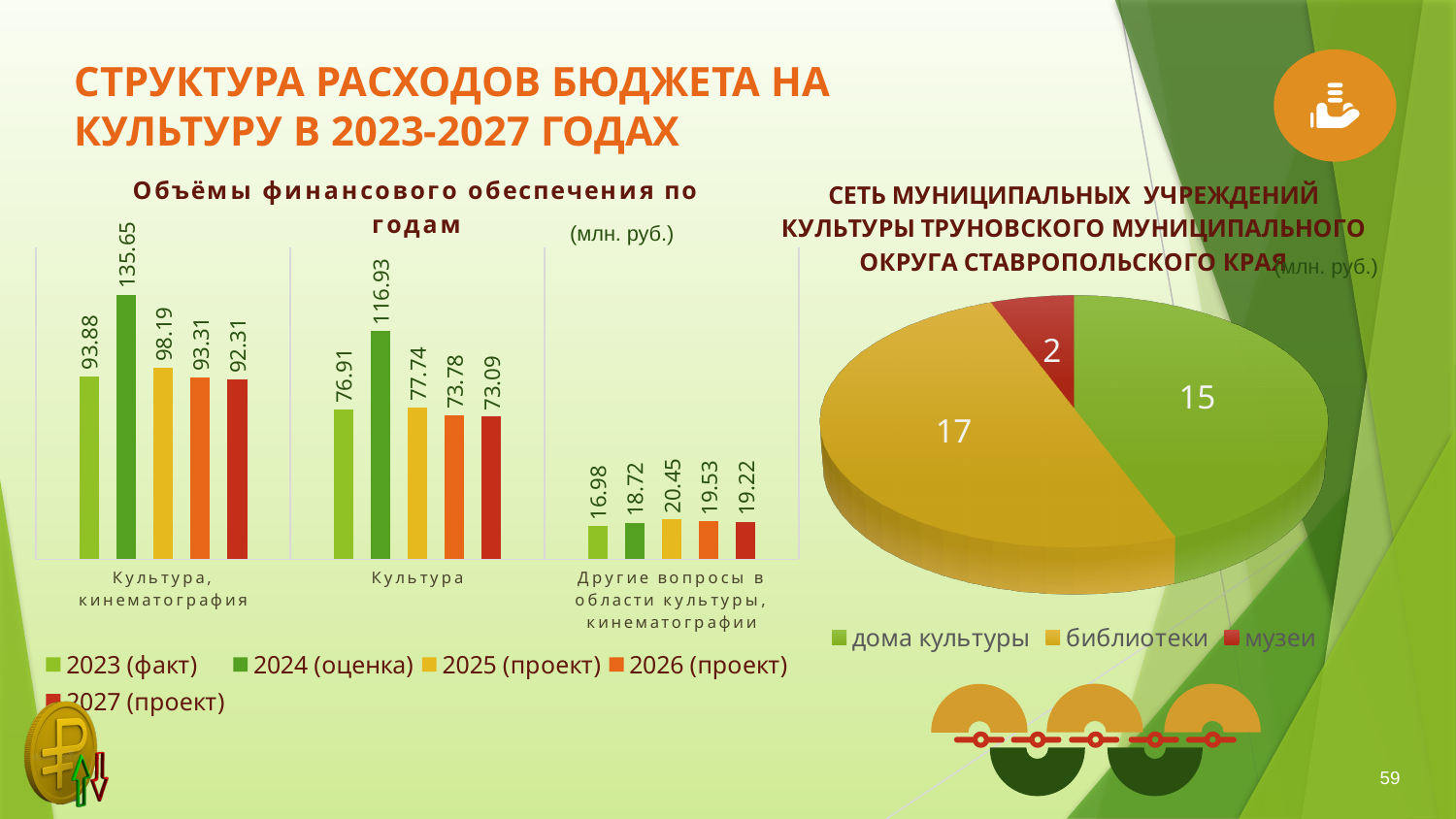
In the bar chart "Объёмы финансового обеспечения по годам", what is the value for "Другие вопросы в области культуры, кинематографии" in 2025 (проект)? 20.45 In the bar chart "Объёмы финансового обеспечения по годам", which year has the lowest value for "Другие вопросы в области культуры, кинематографии"? 2023 (факт) In the bar chart "Объёмы финансового обеспечения по годам", what is the value for "Культура" in 2027 (проект)? 73.09 In the pie chart on the right, what is the total of all slices? 34 In the bar chart "Объёмы финансового обеспечения по годам", which year has the highest value for "Культура, кинематография"? 2024 (оценка) In the pie chart on the right, what is the value for "библиотеки"? 17 In the bar chart "Объёмы финансового обеспечения по годам", what is the value for "Культура, кинематография" in 2024 (оценка)? 135.65 In the bar chart "Объёмы финансового обеспечения по годам", which is larger for "Культура, кинематография": the 2025 (проект) value or the 2026 (проект) value? 2025 (проект) In the pie chart on the right, which category has the smallest slice? музеи How many categories are shown on the x axis of the bar chart "Объёмы финансового обеспечения по годам"? 3 How many series does the legend of the bar chart "Объёмы финансового обеспечения по годам" list? 5 In the bar chart "Объёмы финансового обеспечения по годам", what is the difference between the 2024 (оценка) and 2023 (факт) values for "Культура"? 40.02